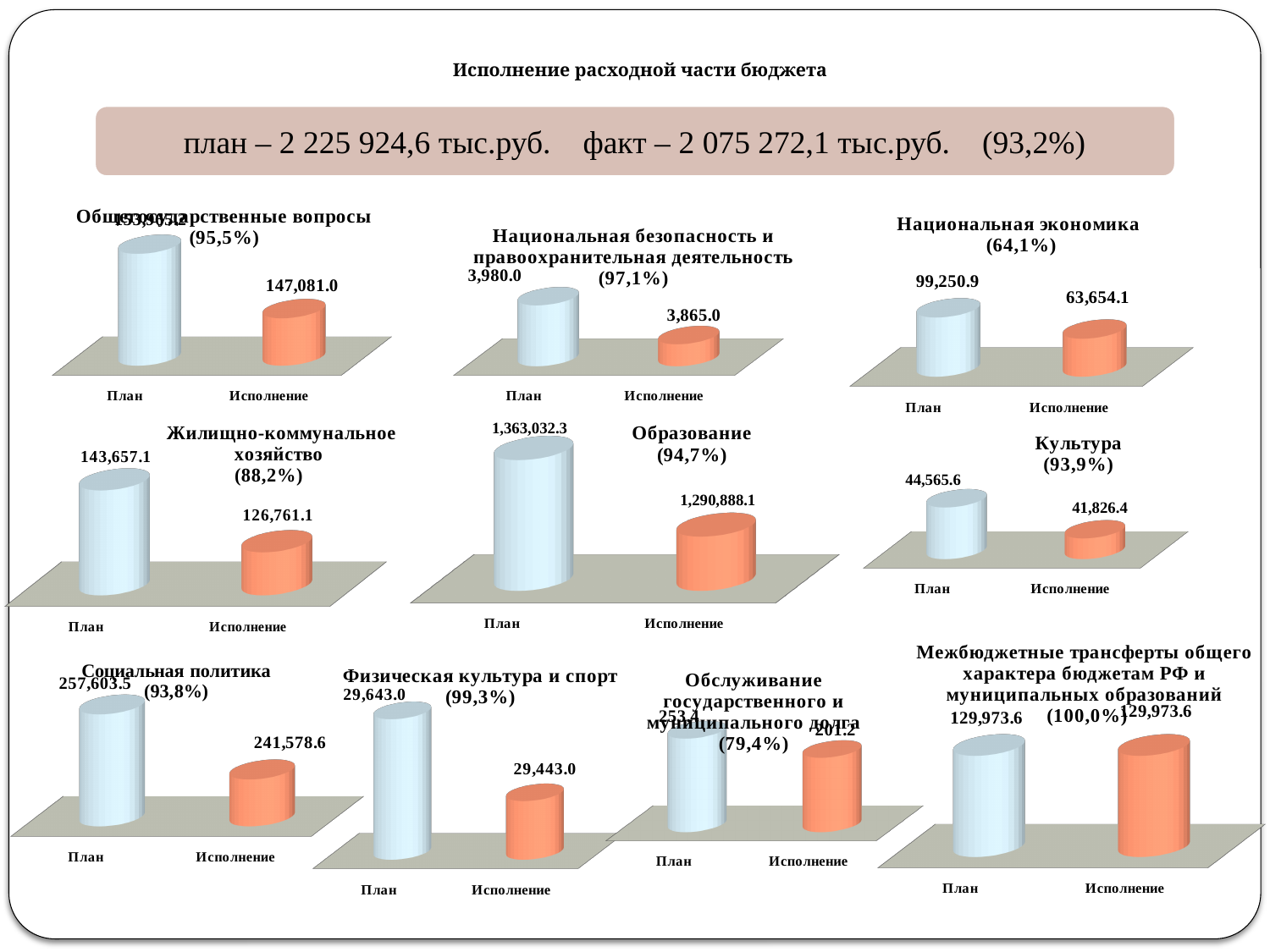
In the 'Жилищно-коммунальное хозяйство' chart, what is the value for План? 143,657.1 In the 'Национальная экономика' chart, which is larger, План or Исполнение? План What kind of chart is the 'Культура' chart? Bar chart How many categories does the 'Межбюджетные трансферты общего характера бюджетам РФ и муниципальных образований' chart show? 2 In the 'Национальная экономика' chart, what is the value for План? 99,250.9 In the 'Культура' chart, what is the difference between План and Исполнение? 2,739.2 In the 'Обслуживание государственного и муниципального долга' chart, what is the value for Исполнение? 201.2 What percentage is shown in the title of the 'Национальная экономика' chart? 64,1% In the 'Социальная политика' chart, which category has the lowest value? Исполнение In the 'Национальная безопасность и правоохранительная деятельность' chart, what is the difference between План and Исполнение? 115.0 In the 'Физическая культура и спорт' chart, what is the difference between План and Исполнение? 200.0 In the 'Образование' chart, what is the value for Исполнение? 1,290,888.1